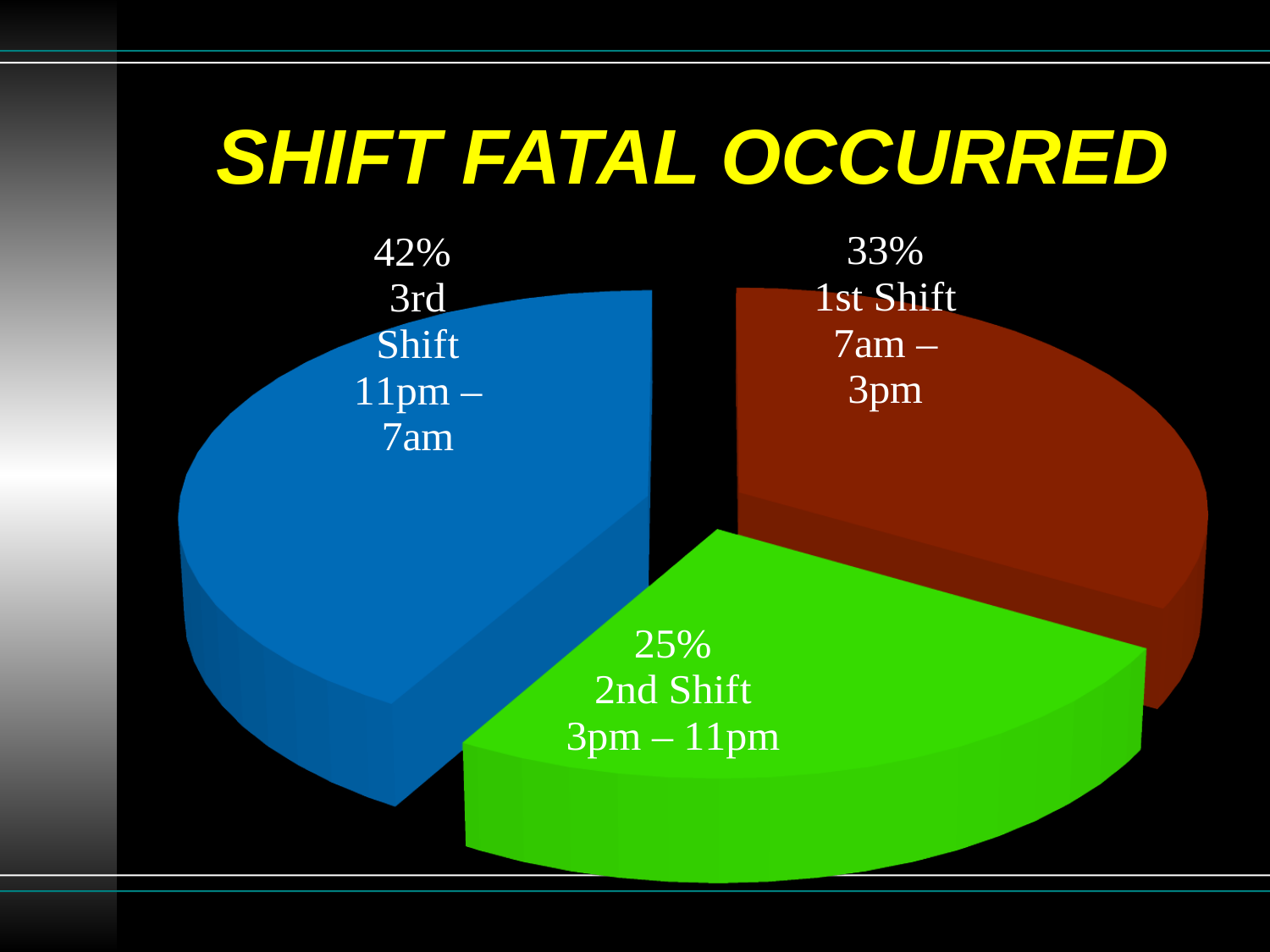
What is the title of the chart? SHIFT FATAL OCCURRED How many slices does the pie chart have? 3 What kind of chart is shown on the slide? pie chart What colour is the slice for the 2nd Shift (3pm – 11pm)? green What percentage of fatalities occurred on the 3rd Shift (11pm – 7am)? 42% What percentage of fatalities occurred on the 2nd Shift (3pm – 11pm)? 25% What is the difference in percentage points between the 1st Shift and the 2nd Shift? 8 Which shift has the smallest share of fatalities? 2nd Shift (3pm – 11pm) Which shift has the largest share of fatalities? 3rd Shift (11pm – 7am) What is the difference in percentage points between the 3rd Shift and the 2nd Shift? 17 What percentage of fatalities occurred on the 1st Shift (7am – 3pm)? 33% Which has a larger share, the 1st Shift or the 2nd Shift? 1st Shift